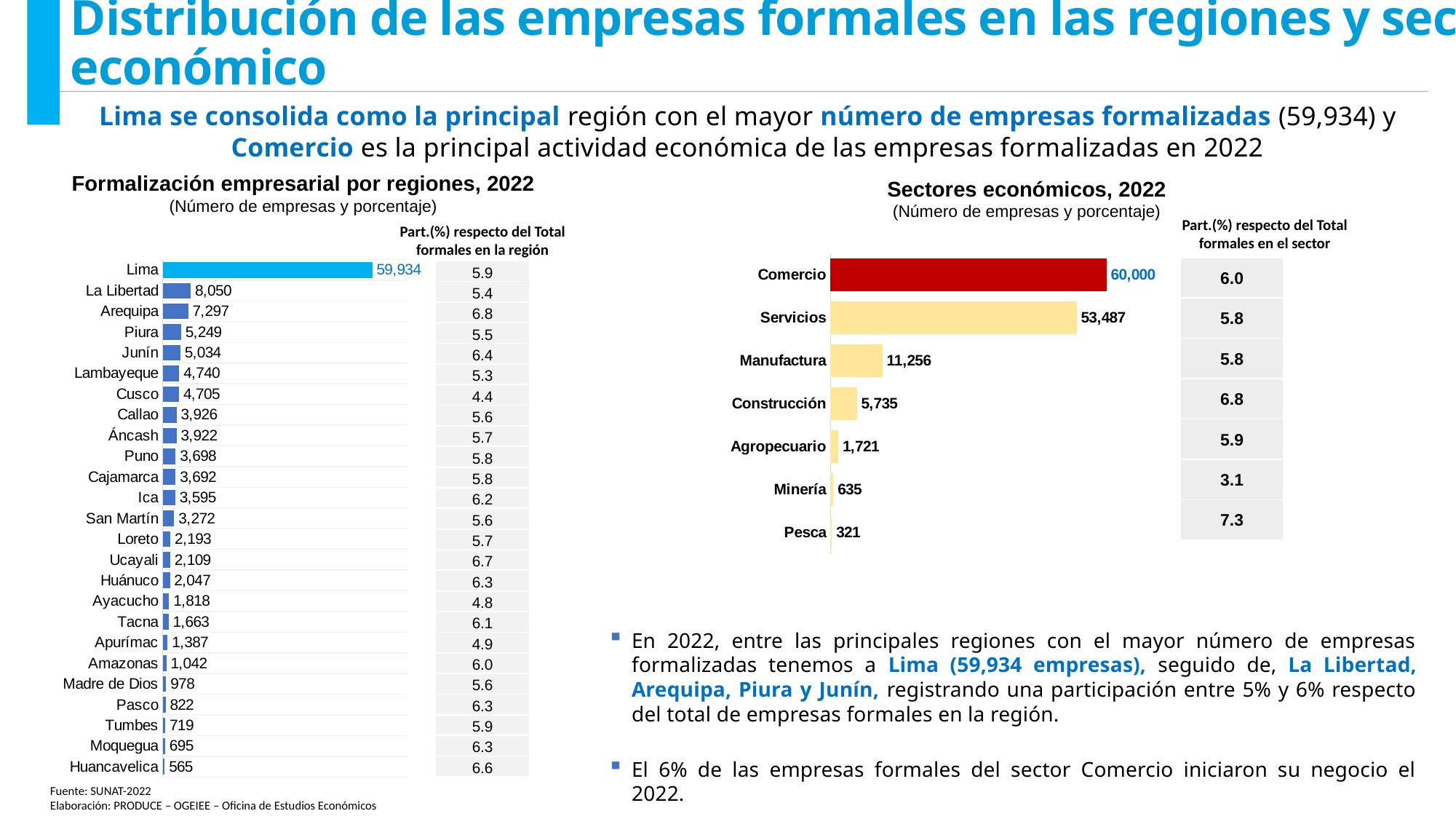
In the 'Formalización empresarial por regiones, 2022' chart, what is the value for Arequipa? 7,297 In the 'Formalización empresarial por regiones, 2022' chart, which region has the highest number of companies? Lima In the 'Formalización empresarial por regiones, 2022' chart, how many regions are shown? 25 What type of chart is the 'Sectores económicos, 2022' chart? Bar chart In the 'Formalización empresarial por regiones, 2022' chart, which region has the lowest number of companies? Huancavelica In the 'Sectores económicos, 2022' chart, how many sectors are shown? 7 In the 'Sectores económicos, 2022' chart, which sector has the lowest number of companies? Pesca In the 'Formalización empresarial por regiones, 2022' chart, what is the difference between the values for Lima and La Libertad? 51,884 In the 'Sectores económicos, 2022' chart, which is larger, Manufactura or Construcción? Manufactura In the 'Formalización empresarial por regiones, 2022' chart, what is the value for Cusco? 4,705 In the 'Sectores económicos, 2022' chart, what is the value for Servicios? 53,487 In the 'Sectores económicos, 2022' chart, what is the difference between the values for Comercio and Servicios? 6,513